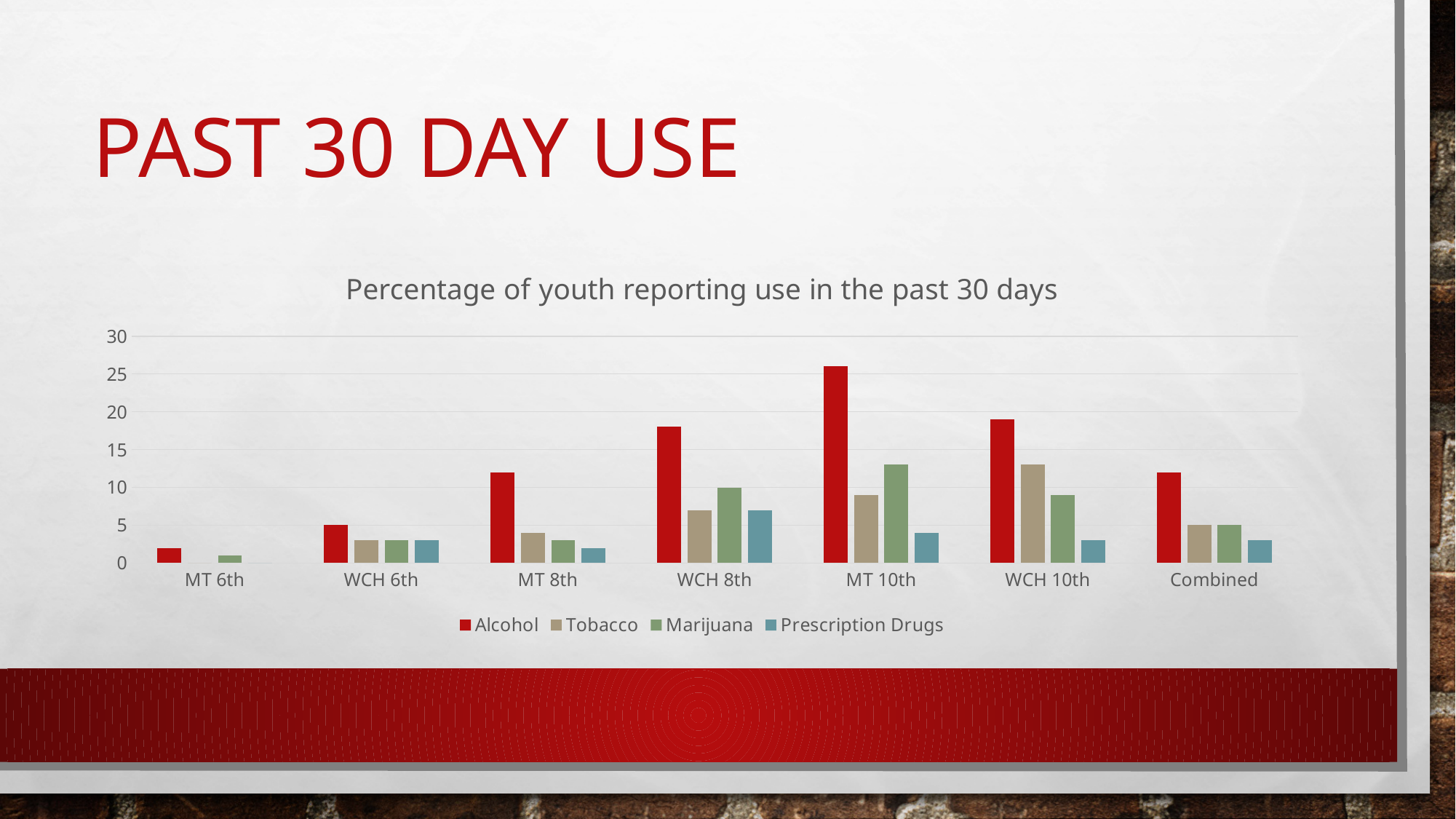
Which category has the lowest Alcohol value? MT 6th Which category has the highest Alcohol value? MT 10th Which is larger for MT 10th: the Marijuana value or the Tobacco value? Marijuana What is the title of the chart? Percentage of youth reporting use in the past 30 days How many categories are shown along the x axis? 7 Which is larger: the Alcohol value for WCH 10th or the Alcohol value for MT 8th? WCH 10th Is the Tobacco value for WCH 10th greater or less than 10? greater Is the Alcohol value for WCH 8th greater or less than 15? greater How many series does the legend list? 4 What kind of chart is shown on the slide? bar chart Which series is shown in red? Alcohol Is the Alcohol value for MT 10th greater or less than 25? greater